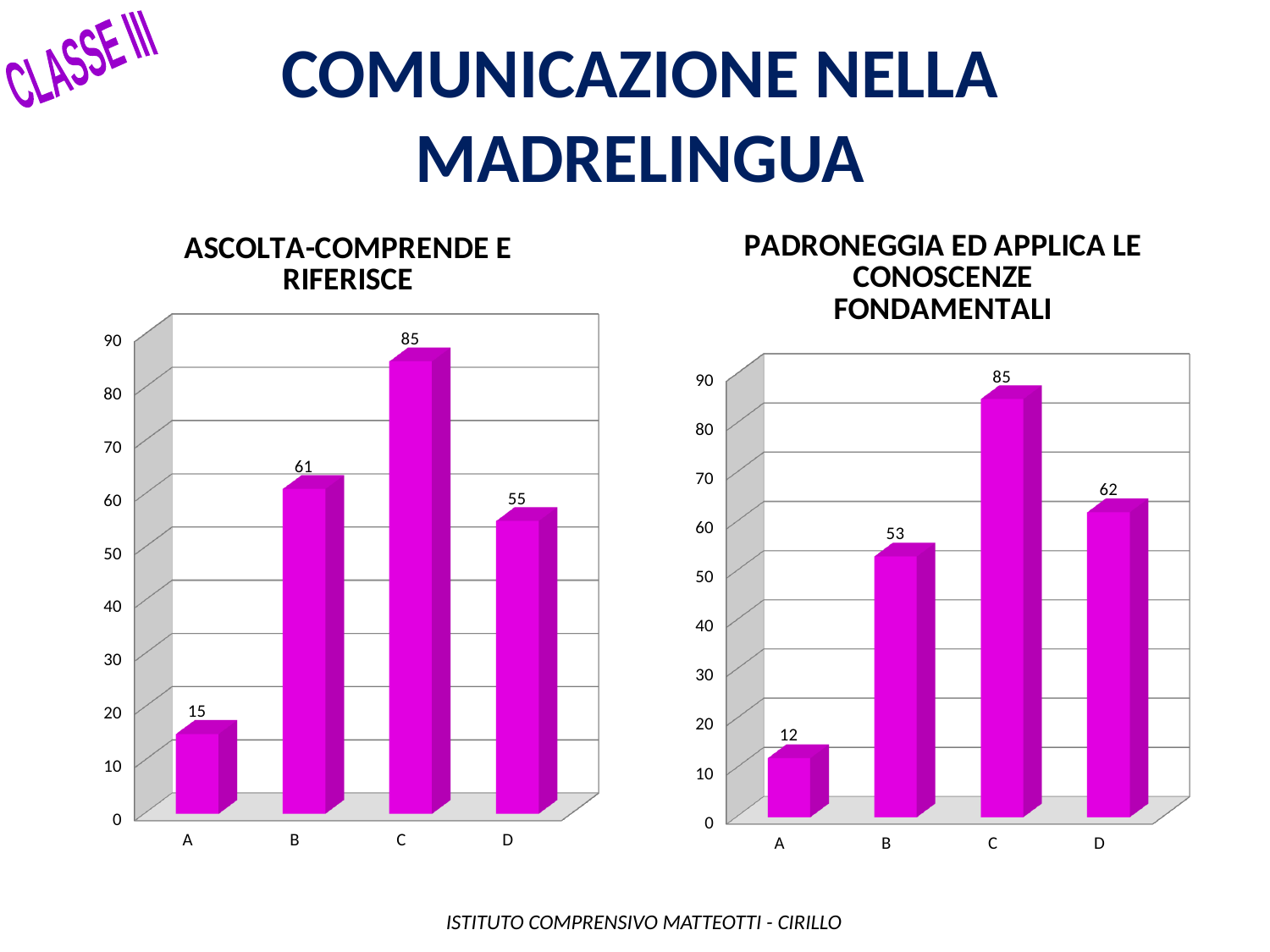
In the 'PADRONEGGIA ED APPLICA LE CONOSCENZE FONDAMENTALI' chart, what is the value for category B? 53 In the 'PADRONEGGIA ED APPLICA LE CONOSCENZE FONDAMENTALI' chart, what is the difference between the values for C and A? 73 In the 'PADRONEGGIA ED APPLICA LE CONOSCENZE FONDAMENTALI' chart, which is larger, the value for B or the value for D? D How many categories are shown in the 'ASCOLTA-COMPRENDE E RIFERISCE' chart? 4 What is the title of the chart on the left side of the slide? ASCOLTA-COMPRENDE E RIFERISCE In the 'ASCOLTA-COMPRENDE E RIFERISCE' chart, what is the difference between the values for B and D? 6 In the 'ASCOLTA-COMPRENDE E RIFERISCE' chart, what is the value for category A? 15 In the 'PADRONEGGIA ED APPLICA LE CONOSCENZE FONDAMENTALI' chart, which category has the highest value? C In the 'ASCOLTA-COMPRENDE E RIFERISCE' chart, which category has the lowest value? A In the 'PADRONEGGIA ED APPLICA LE CONOSCENZE FONDAMENTALI' chart, what is the value for category D? 62 In the 'ASCOLTA-COMPRENDE E RIFERISCE' chart, what is the value for category C? 85 What kind of chart is the 'PADRONEGGIA ED APPLICA LE CONOSCENZE FONDAMENTALI' chart? Bar chart